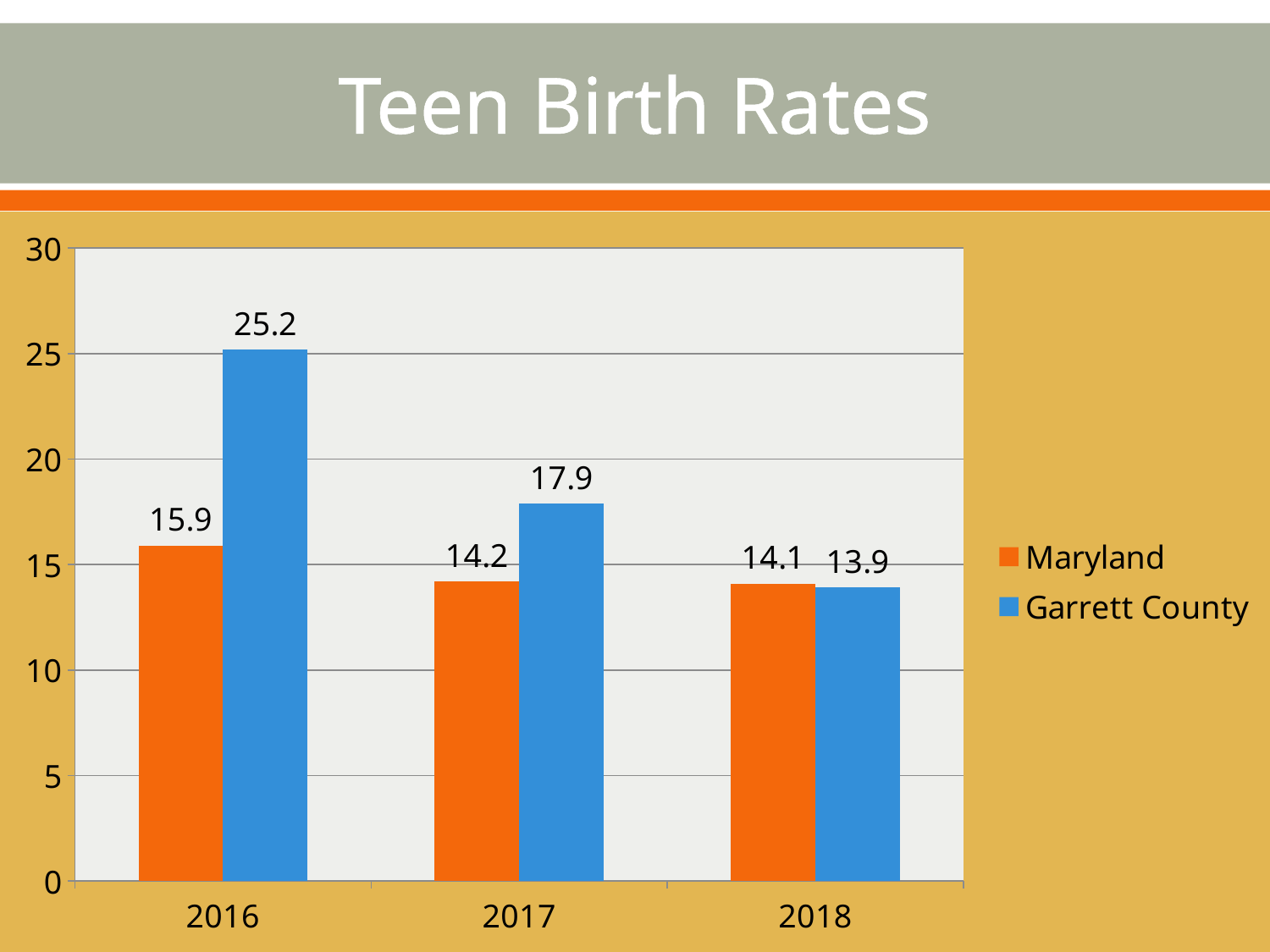
In 2017, which is larger: the Maryland value or the Garrett County value? Garrett County What is the difference between the Garrett County and Maryland values in 2017? 3.7 What is the Garrett County teen birth rate for 2016? 25.2 What is the Garrett County value for 2018? 13.9 How many series does the legend list? 2 In which year is the Maryland teen birth rate lowest? 2018 In which year is the Garrett County teen birth rate highest? 2016 Does the Garrett County teen birth rate rise or fall from 2016 to 2018? fall What is the Maryland teen birth rate for 2017? 14.2 Is the Garrett County value for 2016 greater or less than 20? greater How many years are shown on the x axis? 3 What is the difference between the Garrett County and Maryland values in 2016? 9.3